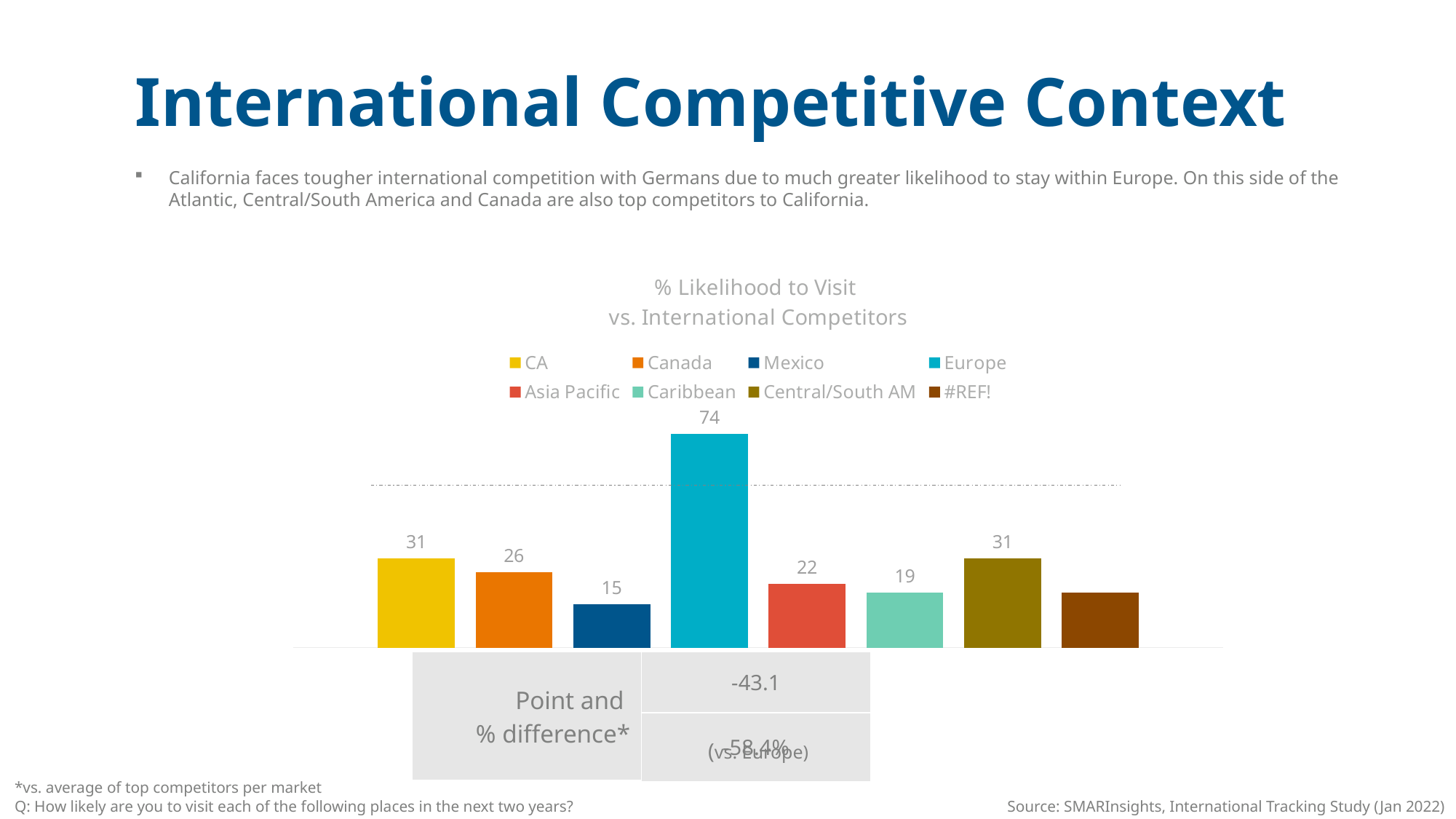
What is the value for Caribbean in the chart? 19 How many bars are plotted in the chart? 8 What is the difference between the values for Canada and Caribbean? 7 What is the value for Mexico in the chart? 15 How many series does the legend list? 8 Which series has the lowest value in the chart? Mexico What kind of chart is shown on the slide? Bar chart What is the value for Europe in the chart? 74 What is the value for Canada in the chart? 26 Which series has the highest value in the chart? Europe Which is larger, the value for Canada or the value for Asia Pacific? Canada What is the difference between the values for Europe and CA? 43